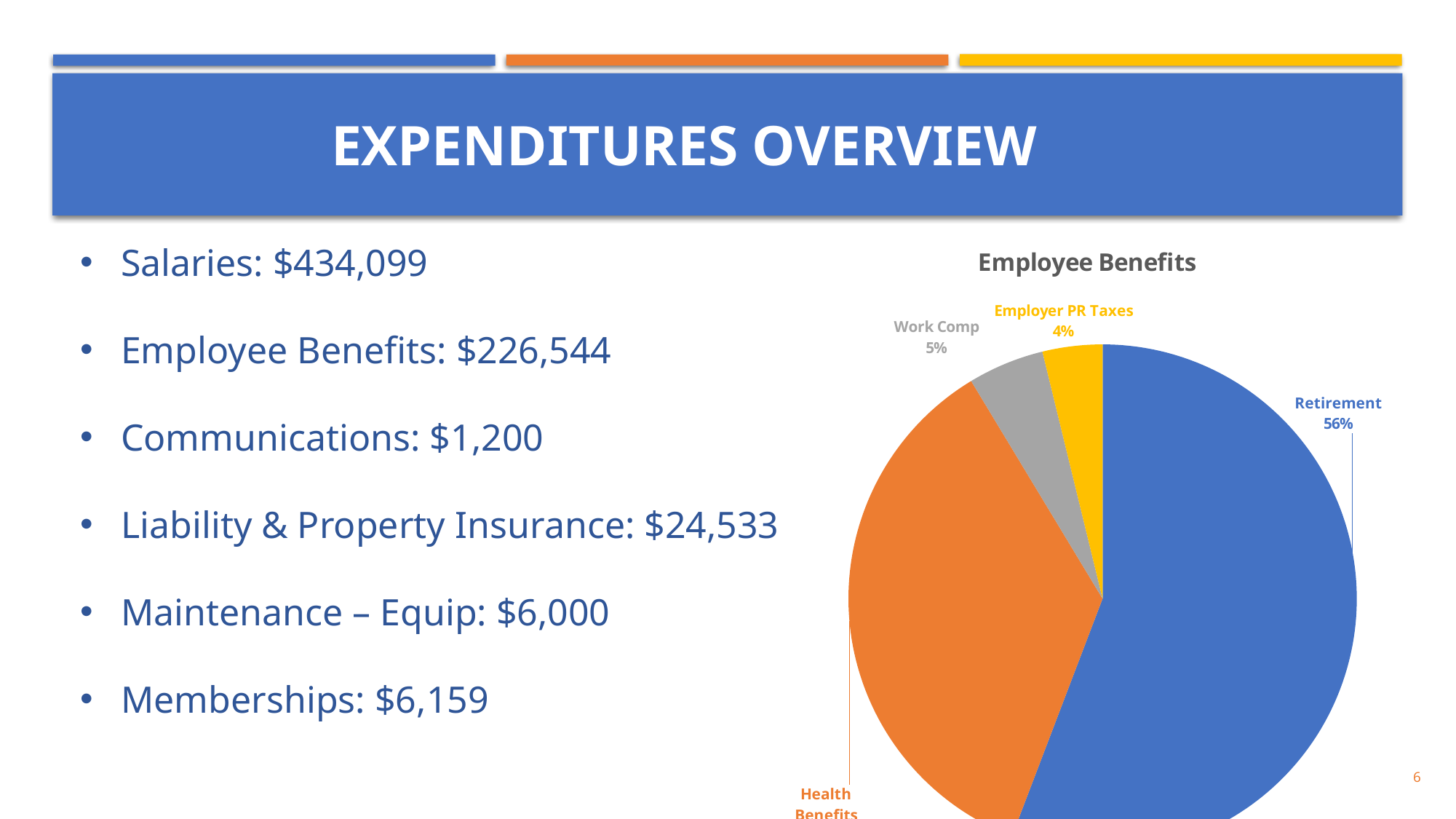
Which is larger, the Retirement slice or the Health Benefits slice? Retirement How many slices does the pie chart have? 4 Which is larger, Work Comp or Employer PR Taxes? Work Comp What is the title of the chart? Employee Benefits By how many percentage points does Retirement exceed Work Comp? 51 What colour is the Retirement slice? blue Which slice of the pie is the smallest? Employer PR Taxes What percentage is shown for Work Comp? 5% What share of the Employee Benefits pie is Retirement? 56% What kind of chart is shown on the slide? pie chart Which slice of the pie is the largest? Retirement What percentage is shown for Employer PR Taxes? 4%